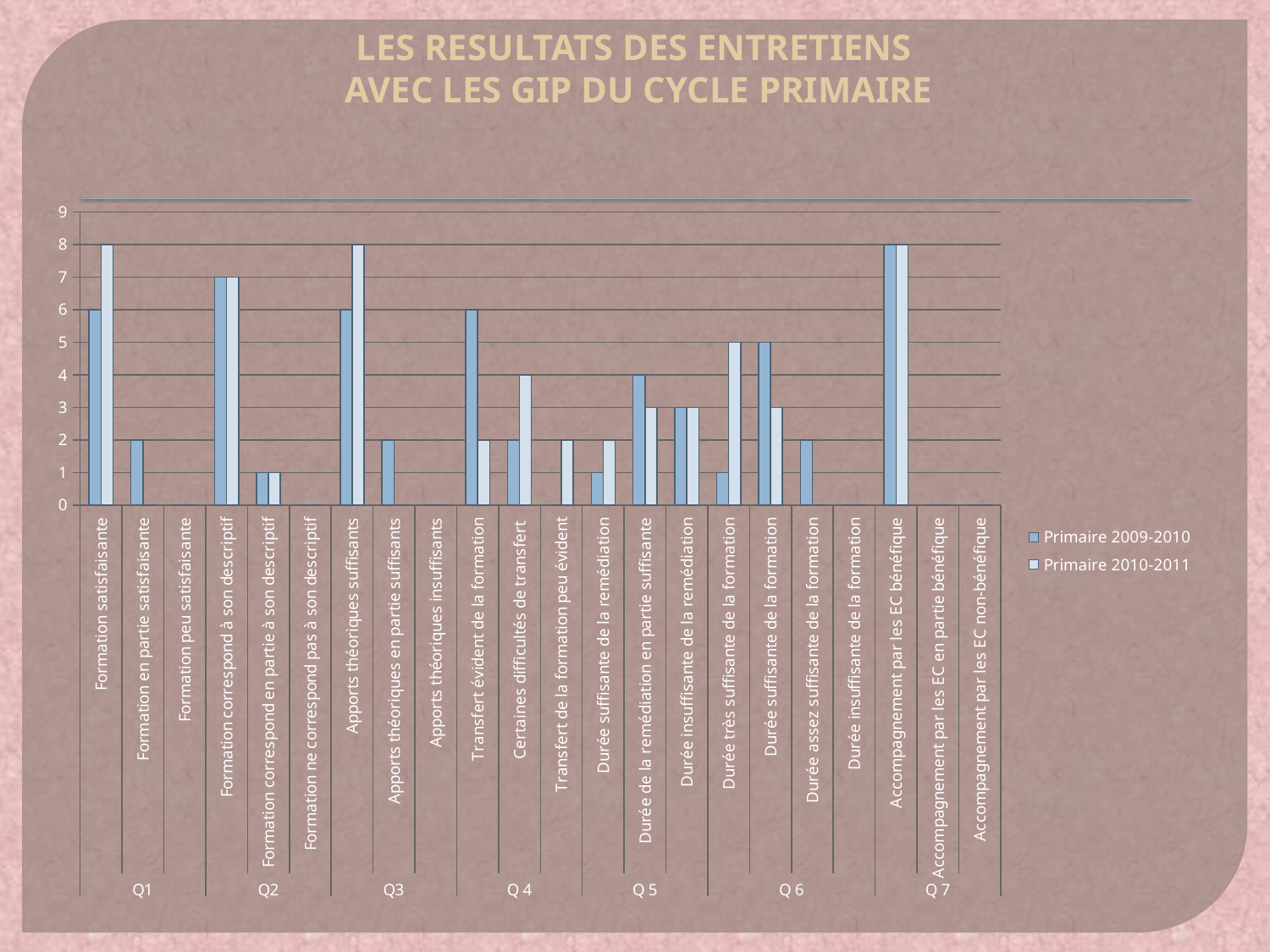
What kind of chart is shown on the slide? Bar chart What is the value for Primaire 2009-2010 for "Formation satisfaisante"? 6 How many series does the legend list? 2 What is the value for Primaire 2010-2011 for "Apports théoriques suffisants"? 8 What is the value for Primaire 2009-2010 for "Accompagnement par les EC bénéfique"? 8 How many categories are shown on the x axis? 22 Is the Primaire 2010-2011 value for "Formation correspond à son descriptif" greater or less than 5? greater What is the title of the slide? LES RESULTATS DES ENTRETIENS AVEC LES GIP DU CYCLE PRIMAIRE What is the value for Primaire 2009-2010 for "Transfert évident de la formation"? 6 What is the value for Primaire 2010-2011 for "Durée très suffisante de la formation"? 5 What is the difference between the Primaire 2010-2011 and Primaire 2009-2010 values for "Certaines difficultés de transfert"? 2 Which is larger for "Durée suffisante de la formation": Primaire 2009-2010 or Primaire 2010-2011? Primaire 2009-2010